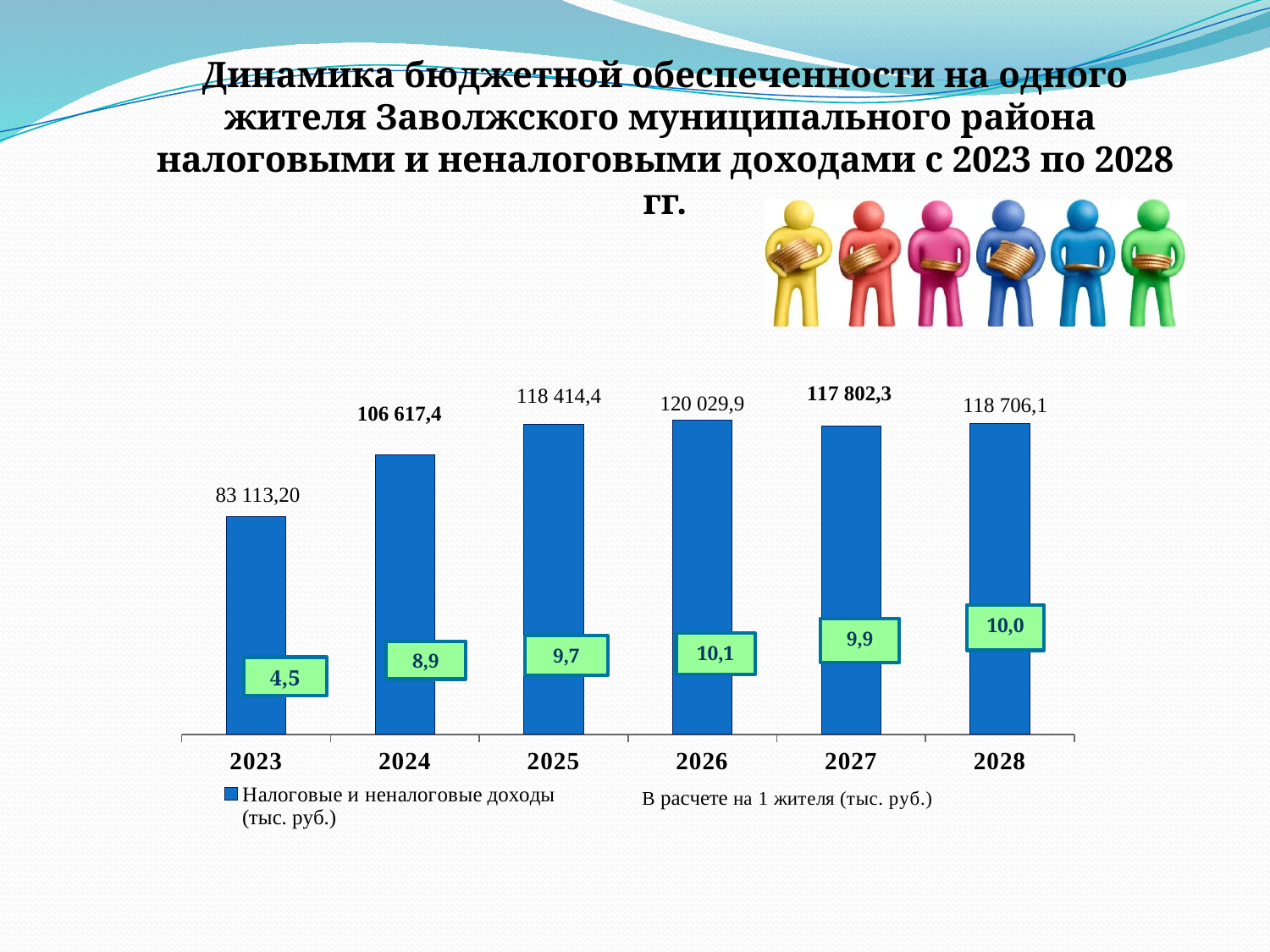
Which year has the lowest value of tax and non-tax revenues? 2023 Which year has the larger per-resident value, 2025 or 2027? 2027 How many series does the legend list? 1 Which year has the highest value of tax and non-tax revenues? 2026 What is the value of tax and non-tax revenues (Налоговые и неналоговые доходы) for 2026? 120 029,9 What is the value of tax and non-tax revenues (Налоговые и неналоговые доходы) for 2023? 83 113,20 How many years are shown on the x axis of the chart? 6 What kind of chart is shown on the slide? bar chart What is the per-resident value (В расчете на 1 жителя) shown for 2024? 8,9 What is the per-resident value (В расчете на 1 жителя) shown for 2028? 10,0 Does the per-resident value (В расчете на 1 жителя) rise or fall from 2023 to 2026? rise What is the difference between the tax and non-tax revenues for 2024 and 2023? 23 504,2